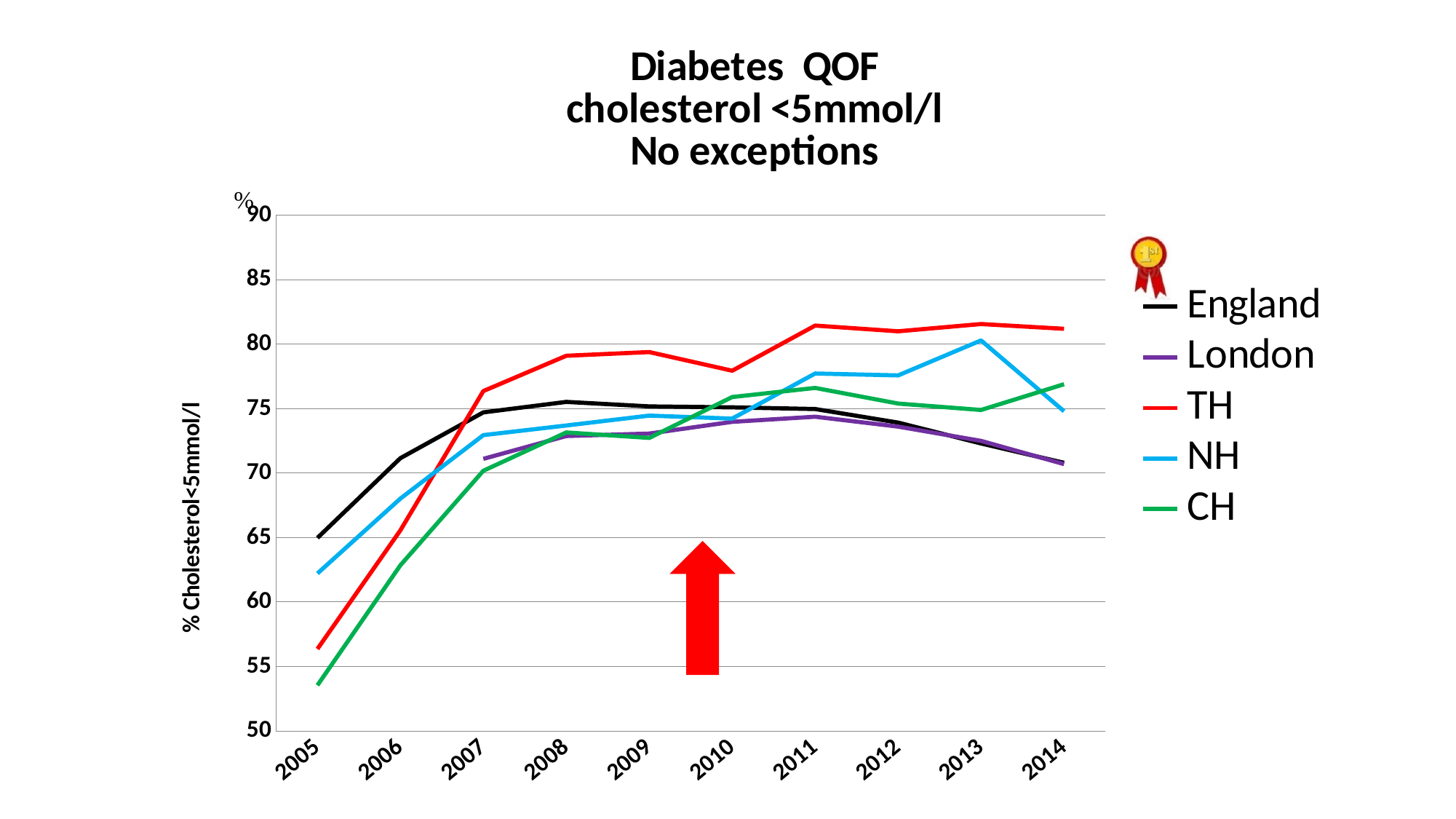
How many series does the legend list? 5 What colour is the TH line in the legend? red Is the value for TH in 2011 greater or less than 80? greater Does the TH line rise or fall between 2005 and 2011? rise Which series has the lowest value in 2005? CH Is the value for TH in 2005 greater or less than 60? less Is the value for CH in 2014 greater or less than 75? greater What kind of chart is shown on the slide? line chart Which series has the highest value in 2014? TH How many years are shown along the x axis? 10 In 2014, which is larger, the value for TH or the value for England? TH